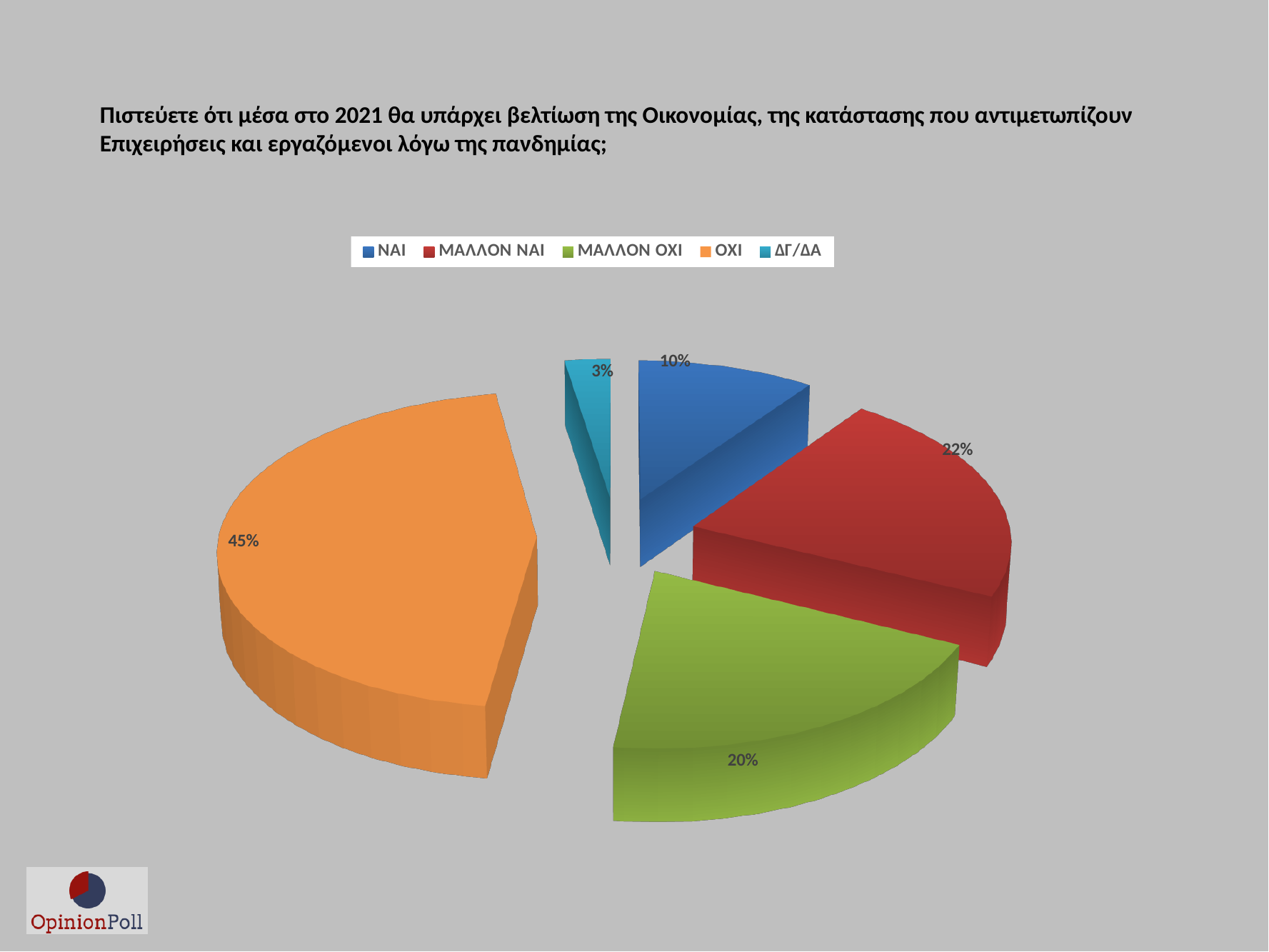
How many entries does the legend list? 5 Which is larger, the share for ΜΑΛΛΟΝ ΝΑΙ or the share for ΜΑΛΛΟΝ ΟΧΙ? ΜΑΛΛΟΝ ΝΑΙ What percentage of respondents answered ΝΑΙ? 10% Which response has the largest share of the pie? ΟΧΙ What type of chart is shown on the slide? pie chart Which response has the smallest share of the pie? ΔΓ/ΔΑ What percentage of respondents answered ΔΓ/ΔΑ? 3% How many slices does the pie chart have? 5 What is the difference in percentage points between ΟΧΙ and ΝΑΙ? 35 What colour is the slice for ΜΑΛΛΟΝ ΟΧΙ? green What percentage of respondents answered ΜΑΛΛΟΝ ΝΑΙ? 22% What percentage of respondents answered ΟΧΙ? 45%